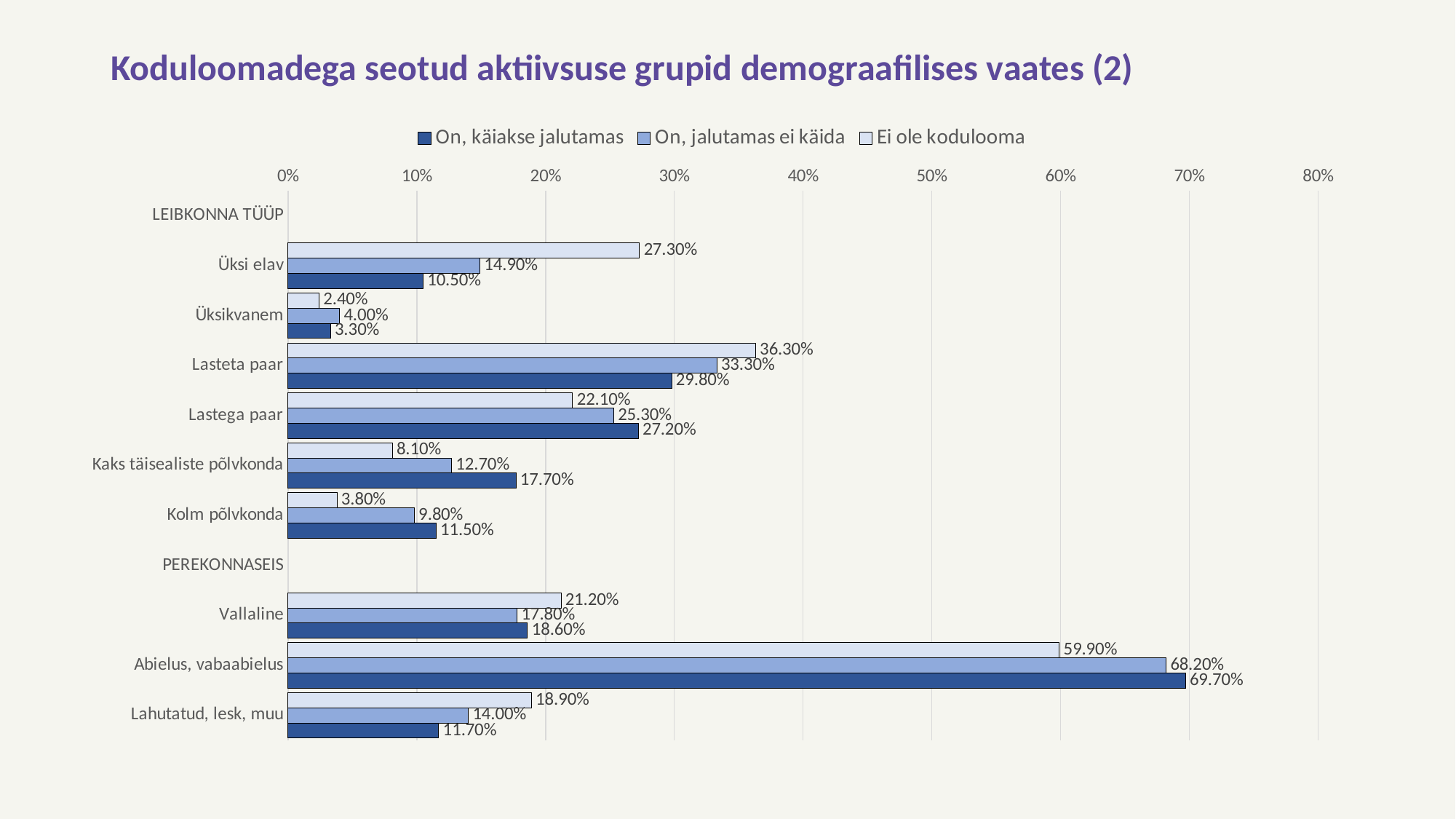
For "Lastega paar", which is larger: the "On, käiakse jalutamas" value or the "Ei ole kodulooma" value? On, käiakse jalutamas How many categories with plotted bars are shown in the chart? 9 What is the title of the chart on the slide? Koduloomadega seotud aktiivsuse grupid demograafilises vaates (2) Which category has the highest value in the "Ei ole kodulooma" series? Abielus, vabaabielus How many series does the legend list? 3 What is the value for "Abielus, vabaabielus" in the "On, käiakse jalutamas" series? 69.70% Is the "On, jalutamas ei käida" value for "Abielus, vabaabielus" greater or less than 60%? greater Which category has the lowest value in the "On, käiakse jalutamas" series? Üksikvanem What is the value for "Üksi elav" in the "Ei ole kodulooma" series? 27.30% What is the value for "Kaks täisealiste põlvkonda" in the "On, jalutamas ei käida" series? 12.70% What is the difference between the "Ei ole kodulooma" and "On, käiakse jalutamas" values for "Lasteta paar"? 6.50% What kind of chart is shown on the slide? Bar chart